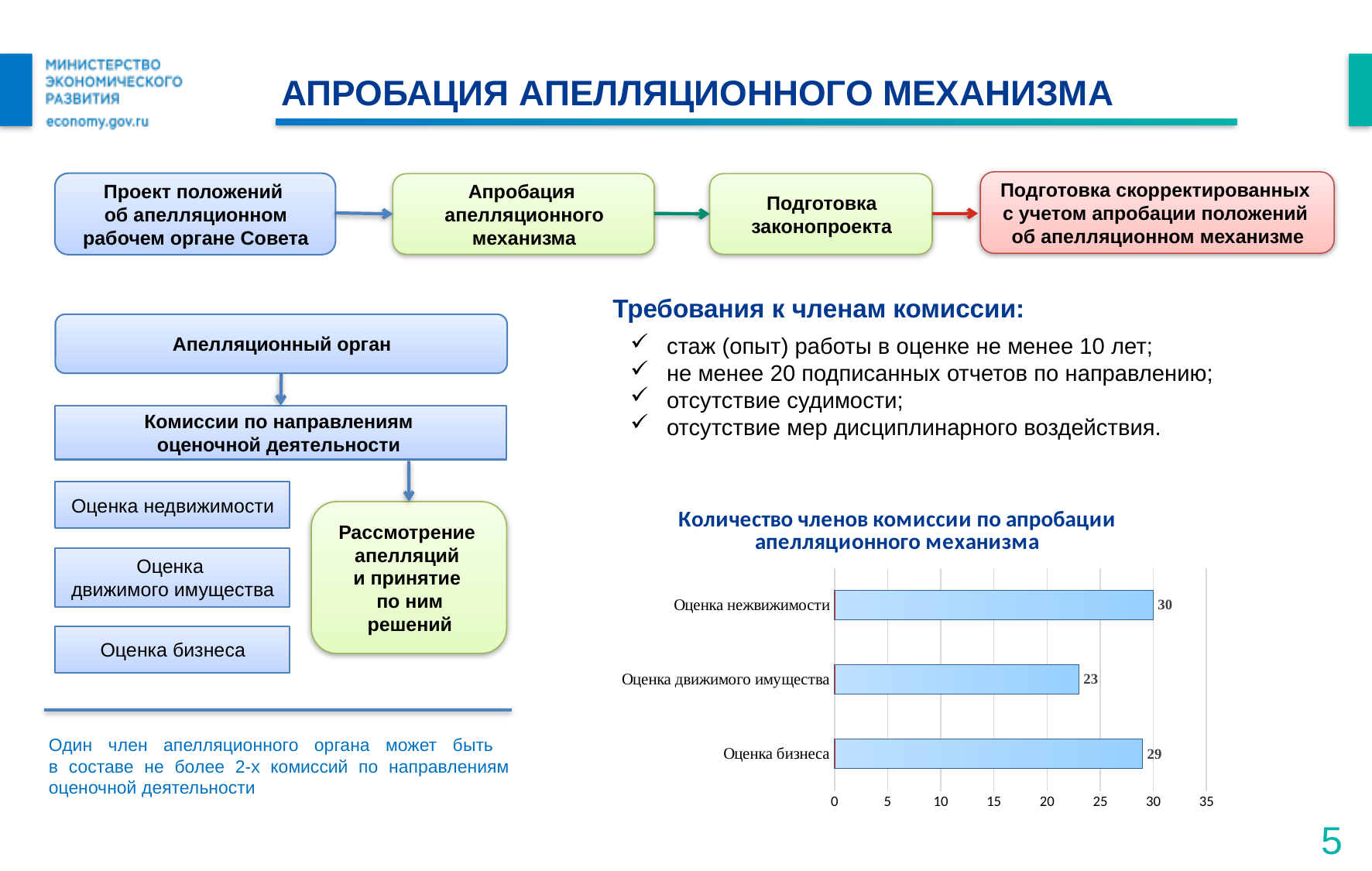
Which category has the lowest value in the chart? Оценка движимого имущества Is the value for Оценка движимого имущества greater or less than 25? less What is the value for Оценка бизнеса in the chart? 29 What is the title of the chart? Количество членов комиссии по апробации апелляционного механизма What is the value for Оценка нежвижимости in the chart? 30 Which category has the highest value in the chart? Оценка нежвижимости What is the difference between the values for Оценка бизнеса and Оценка движимого имущества? 6 What kind of chart is shown on the slide? bar chart Which is larger: the value for Оценка бизнеса or the value for Оценка движимого имущества? Оценка бизнеса What is the difference between the values for Оценка нежвижимости and Оценка движимого имущества? 7 How many categories are shown in the chart? 3 What is the value for Оценка движимого имущества in the chart? 23